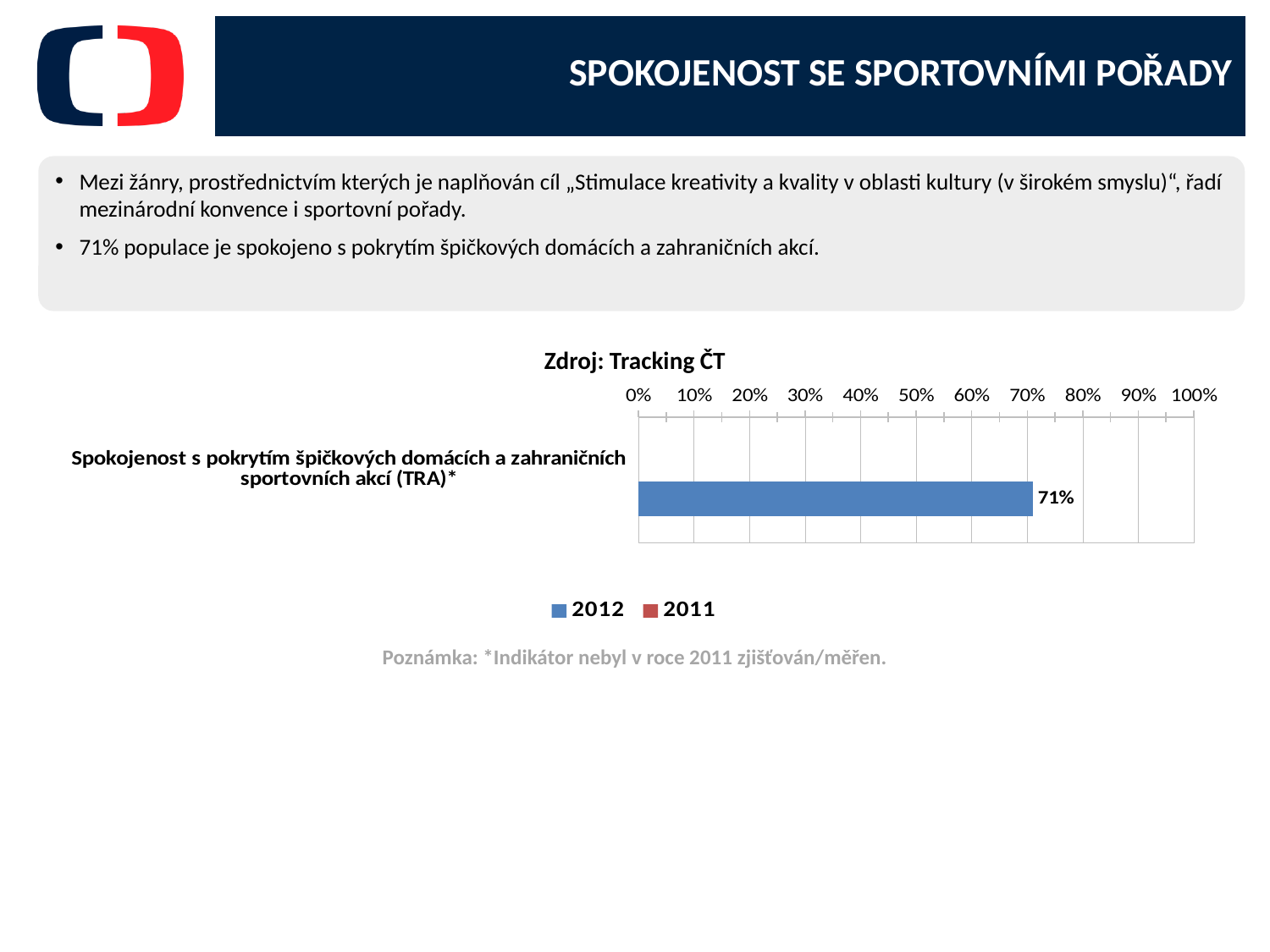
Is the 2012 value for 'Spokojenost s pokrytím špičkových domácích a zahraničních sportovních akcí (TRA)*' greater or less than 80%? less What is the 2012 value for 'Spokojenost s pokrytím špičkových domácích a zahraničních sportovních akcí (TRA)*'? 71% What is the maximum value shown on the x axis? 100% Is the 2012 value for 'Spokojenost s pokrytím špičkových domácích a zahraničních sportovních akcí (TRA)*' greater or less than 50%? greater Which series is shown in blue in the legend? 2012 How many categories are plotted on the chart? 1 What kind of chart is shown on the slide? bar chart What is the title of the chart? Zdroj: Tracking ČT How many series does the legend list? 2